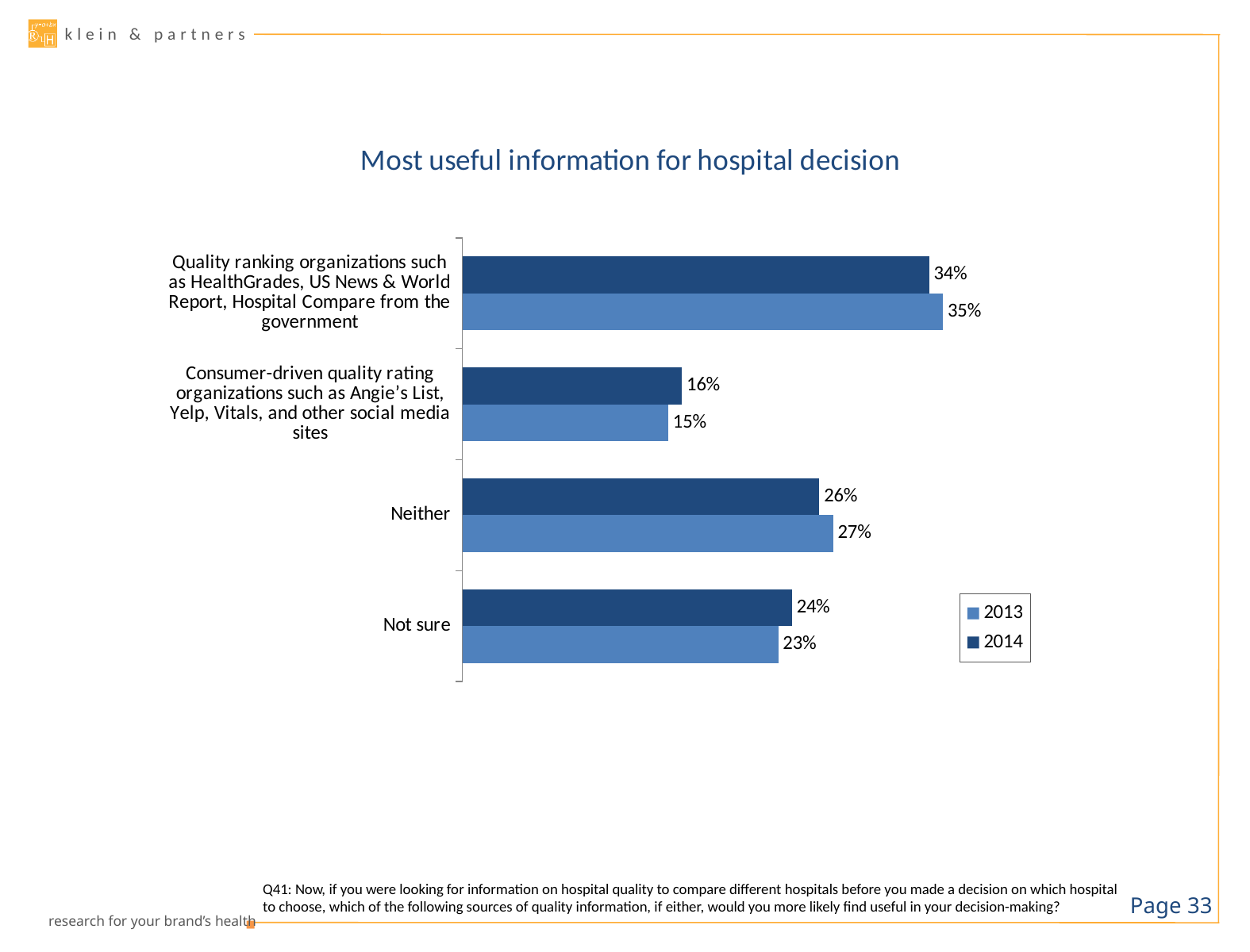
What is the 2014 value for "Neither"? 26% How many categories are shown on the chart? 4 Which category has the lowest 2013 value? Consumer-driven quality rating organizations such as Angie's List, Yelp, Vitals, and other social media sites What is the 2013 value for "Not sure"? 23% Which category has the highest 2014 value? Quality ranking organizations such as HealthGrades, US News & World Report, Hospital Compare from the government How many series does the legend list? 2 What is the 2014 value for consumer-driven quality rating organizations such as Angie's List, Yelp, Vitals, and other social media sites? 16% What is the 2013 value for quality ranking organizations such as HealthGrades, US News & World Report, Hospital Compare from the government? 35% Which is larger for "Not sure": the 2013 value or the 2014 value? 2014 What is the difference between the 2013 and 2014 values for "Neither"? 1% What is the difference between the 2014 values for quality ranking organizations and consumer-driven quality rating organizations? 18% What type of chart is shown on the slide? Bar chart